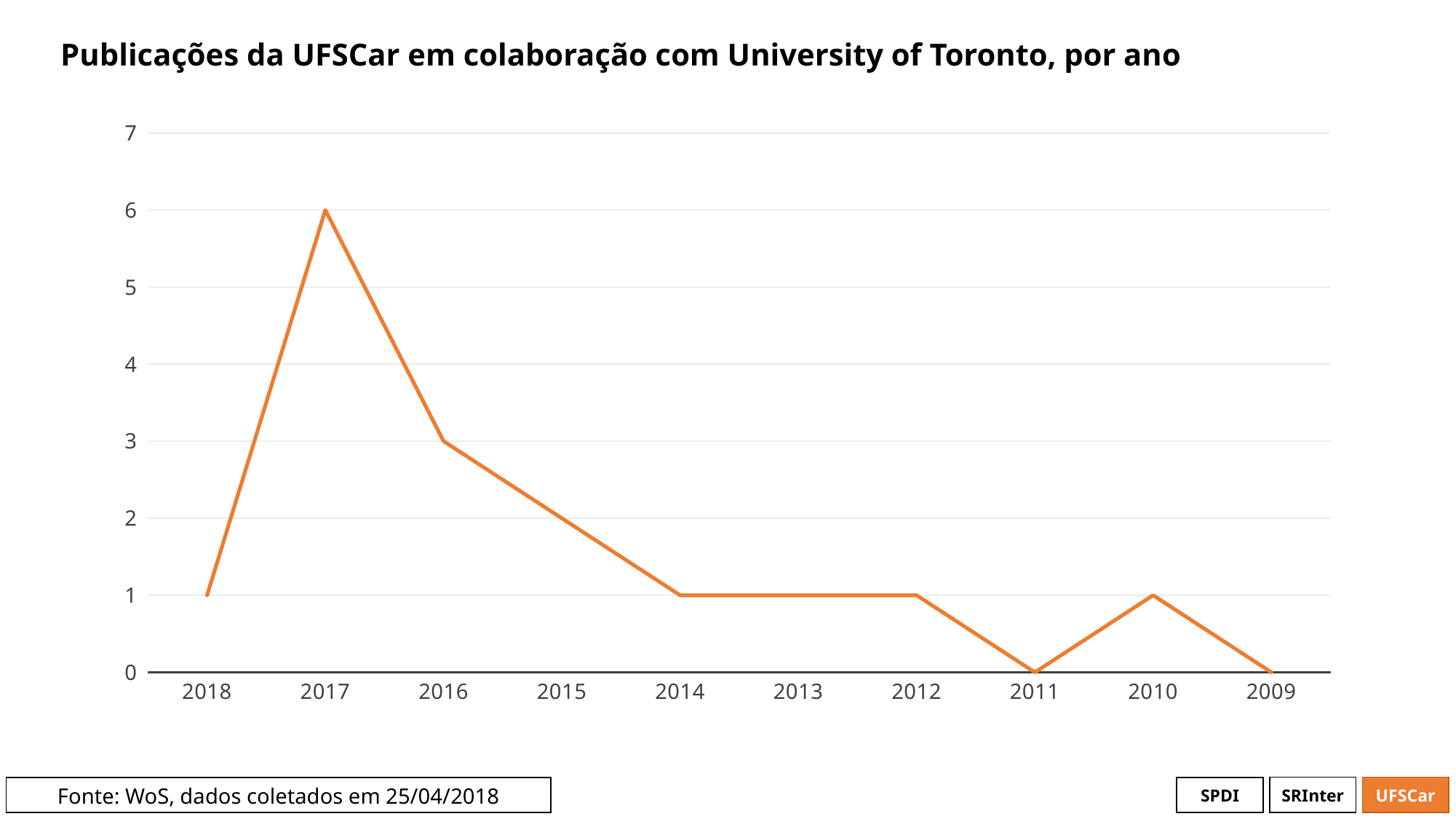
Which year has the highest number of publications? 2017 What is the number of publications in 2018? 1 What is the number of publications in 2011? 0 What is the title of the chart? Publicações da UFSCar em colaboração com University of Toronto, por ano How many years are plotted on the x axis? 10 Which year has more publications, 2010 or 2009? 2010 What is the number of publications in 2017? 6 Is the value for 2017 greater or less than 5? greater Do the values rise or fall from 2017 to 2014 along the x axis? fall What type of chart is shown on the slide? line chart What is the number of publications in 2016? 3 What is the difference between the values for 2017 and 2016? 3